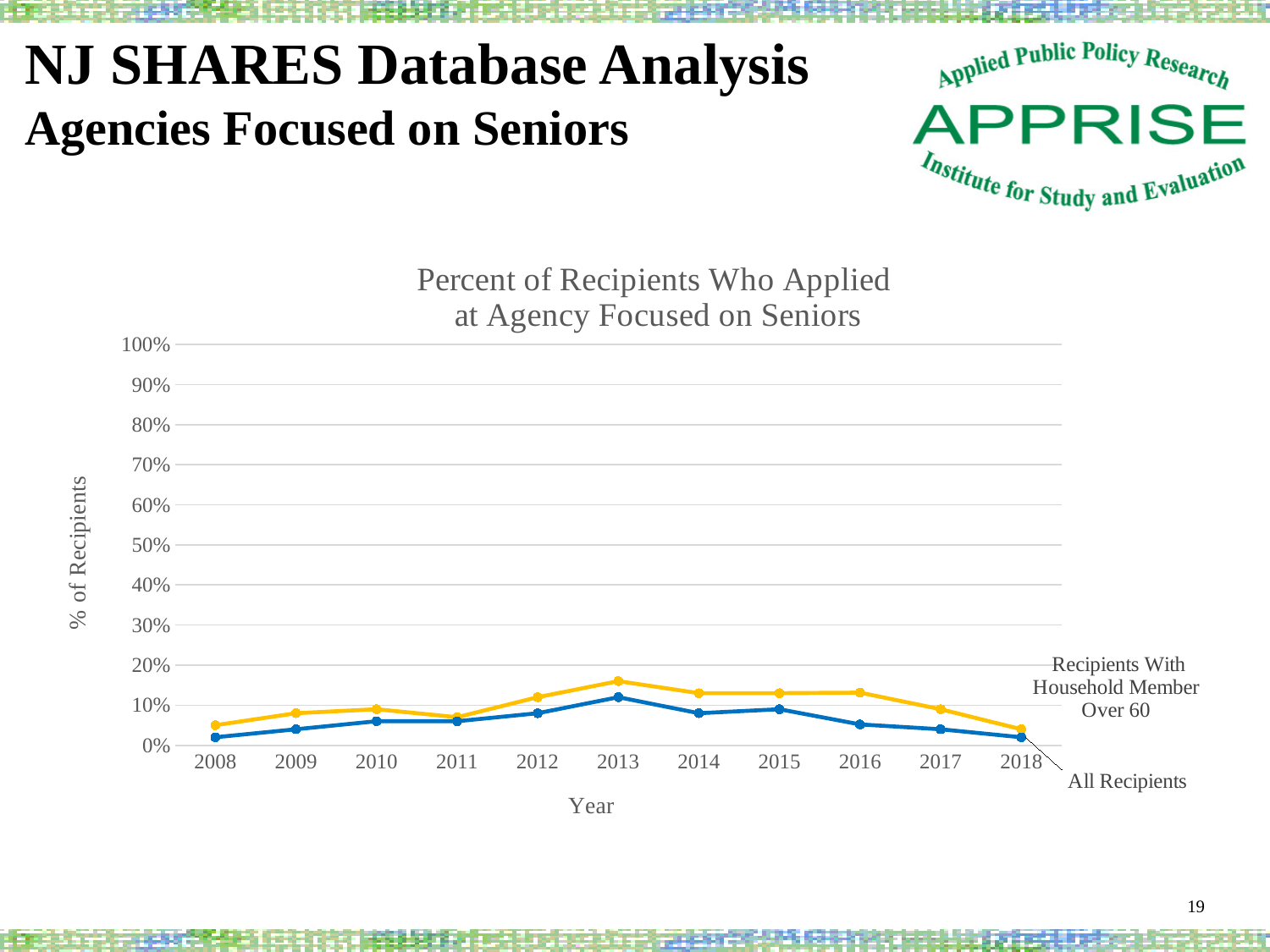
Is the value for 'Recipients With Household Member Over 60' in 2013 greater or less than 20%? less How many series does the chart show? 2 What is the label on the x axis of the chart? Year In which year does the 'All Recipients' line reach its highest value? 2013 Is the value for 'Recipients With Household Member Over 60' in 2013 greater or less than 10%? greater How many years are plotted along the x axis? 11 In 2013, which series has the higher value: 'Recipients With Household Member Over 60' or 'All Recipients'? Recipients With Household Member Over 60 Is the value for 'All Recipients' in 2008 greater or less than 10%? less Does the 'Recipients With Household Member Over 60' line rise or fall from 2013 to 2018? fall What kind of chart is shown on the slide? line chart In which year does the 'Recipients With Household Member Over 60' line reach its highest value? 2013 What is the title of the chart? Percent of Recipients Who Applied at Agency Focused on Seniors